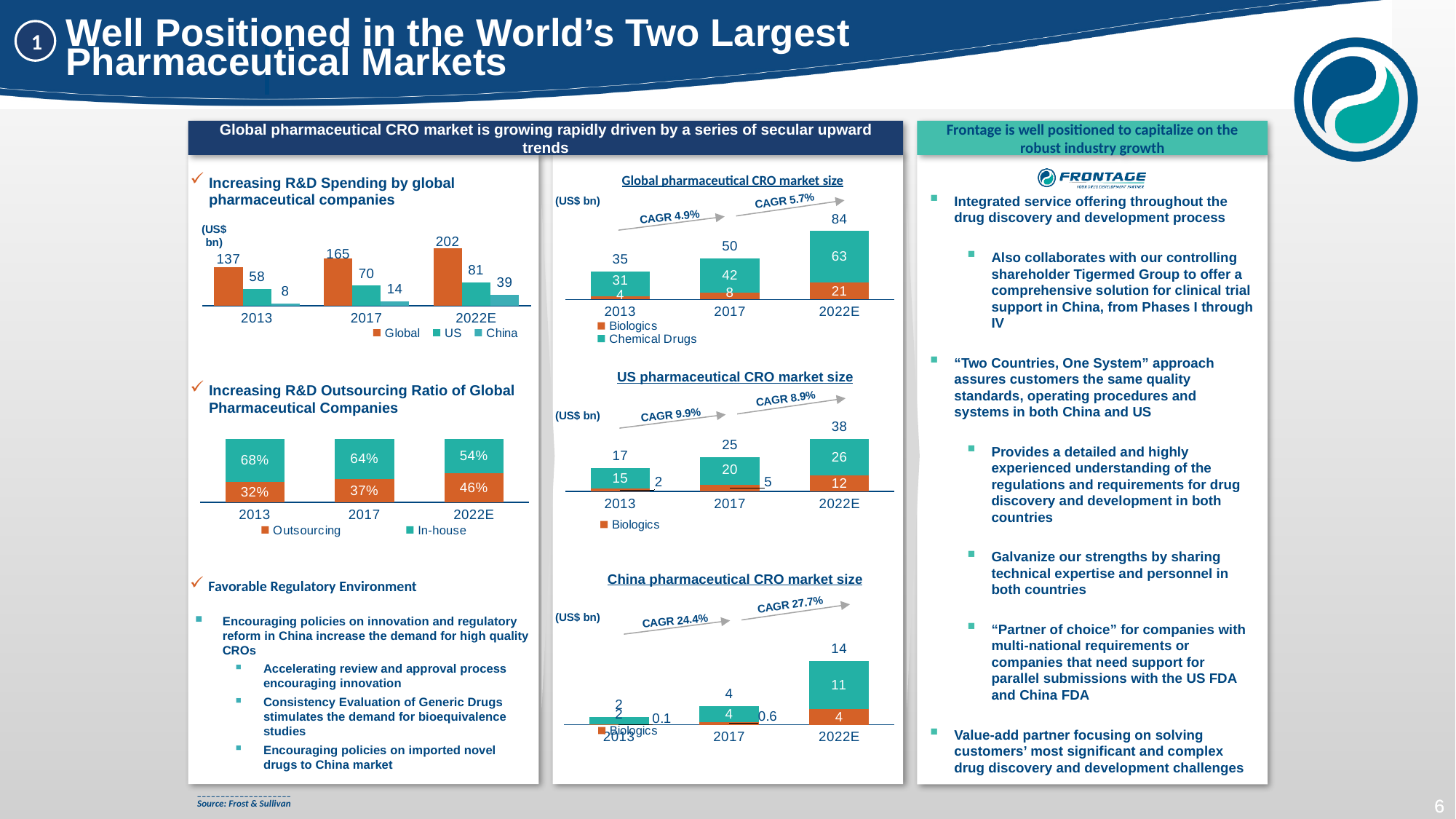
What kind of chart is the 'China pharmaceutical CRO market size' chart? stacked bar chart In the 'Global pharmaceutical CRO market size' chart, what is the difference between the Biologics values for 2022E and 2017? 13 In the 'Global pharmaceutical CRO market size' chart, what is the Chemical Drugs value for 2017? 42 In the 'US pharmaceutical CRO market size' chart, what is the Biologics value for 2022E? 12 In the 'US pharmaceutical CRO market size' chart, which year has the highest total? 2022E In the 'Increasing R&D Outsourcing Ratio of Global Pharmaceutical Companies' chart, does the Outsourcing share rise or fall from 2013 to 2022E? rise In the 'Global pharmaceutical CRO market size' chart, what is the total of the stacked bar for 2022E? 84 In the 'Increasing R&D Outsourcing Ratio of Global Pharmaceutical Companies' chart, what is the Outsourcing share for 2022E? 46% In the 'Increasing R&D Spending by global pharmaceutical companies' chart, what is the Global value for 2022E? 202 In the 'Increasing R&D Spending by global pharmaceutical companies' chart, how many series does the legend list? 3 In the 'Increasing R&D Spending by global pharmaceutical companies' chart, what is the China value for 2017? 14 In the 'China pharmaceutical CRO market size' chart, what is the Biologics value for 2017? 0.6